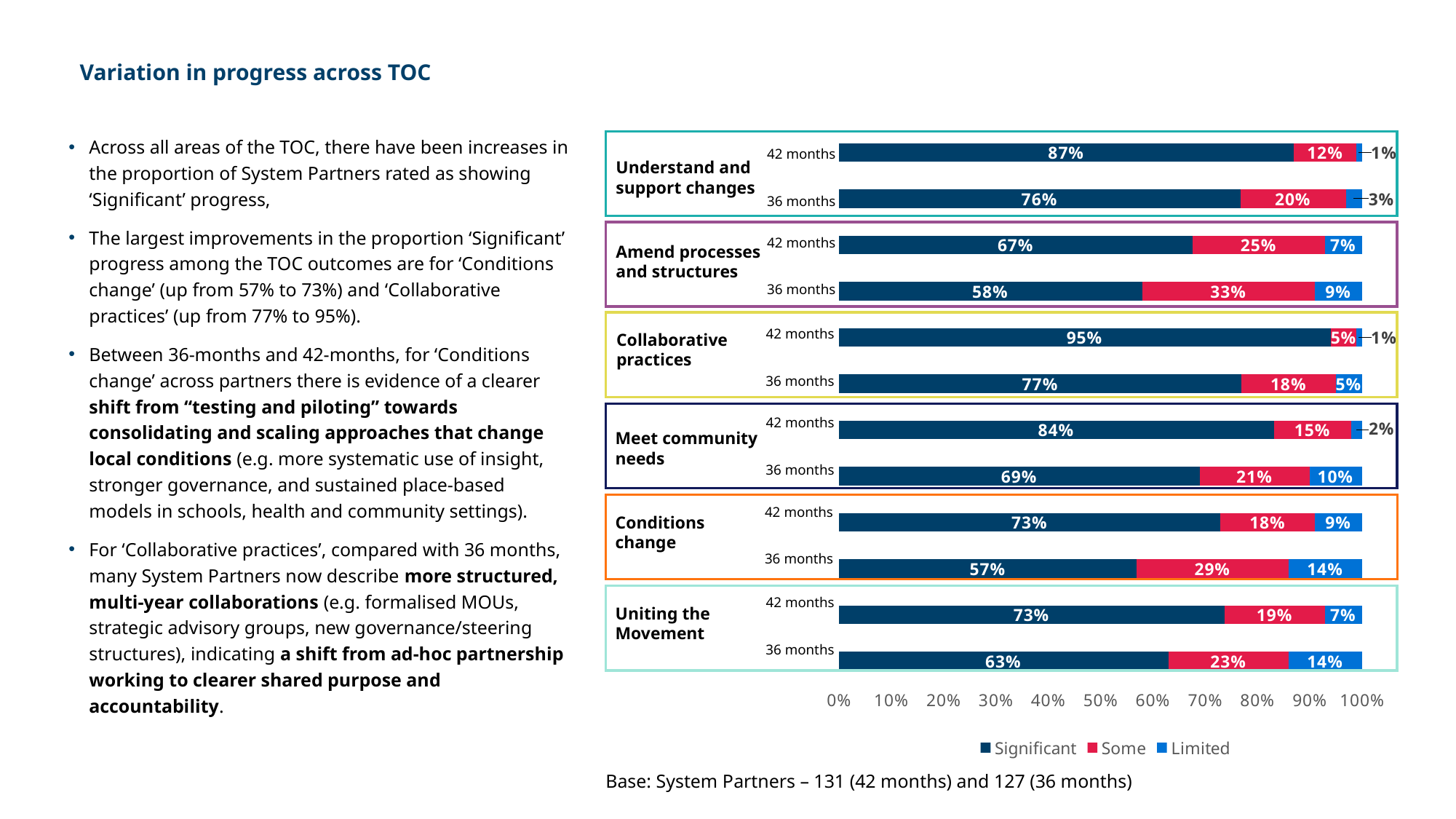
What kind of chart is shown on the slide? Stacked bar chart Which is larger: the 'Some' percentage for 'Uniting the Movement' at 36 months or at 42 months? 36 months Which TOC area has the lowest 'Significant' percentage at 36 months? Conditions change What percentage of System Partners were rated 'Significant' for 'Understand and support changes' at 42 months? 87% Which colour represents the 'Limited' series in the chart? Light blue Which TOC area has the highest 'Significant' percentage at 42 months? Collaborative practices What percentage of System Partners were rated 'Limited' for 'Meet community needs' at 36 months? 10% What is the combined percentage of 'Some' and 'Limited' ratings for 'Collaborative practices' at 42 months? 6% What percentage of System Partners were rated 'Some' for 'Amend processes and structures' at 36 months? 33% How many TOC areas are shown in the chart? 6 By how many percentage points did the 'Significant' rating for 'Conditions change' increase from 36 months to 42 months? 16 percentage points How many series does the legend list? 3